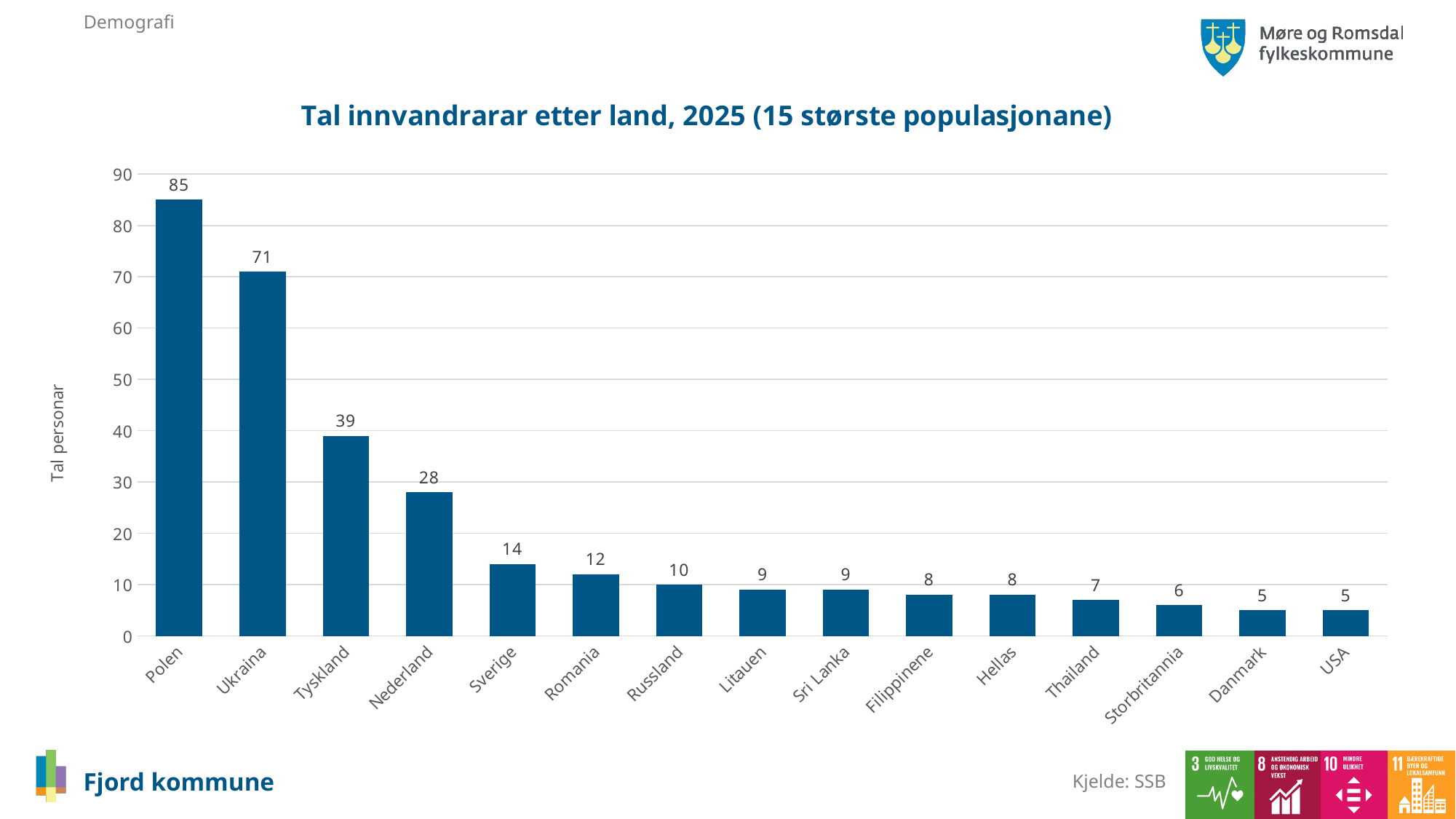
What is the value for Sverige? 14 Which country has the highest value? Polen What is the title of the chart? Tal innvandrarar etter land, 2025 (15 største populasjonane) What is the difference between the values for Polen and Ukraina? 14 What is the value for Tyskland? 39 How many countries are shown on the x axis? 15 What kind of chart is shown on the slide? bar chart What is the value for Polen? 85 Is the value for Ukraina greater or less than 60? greater Do the values rise or fall from left to right along the x axis? fall Which is larger, the value for Romania or the value for Russland? Romania What is the difference between the values for Tyskland and Nederland? 11